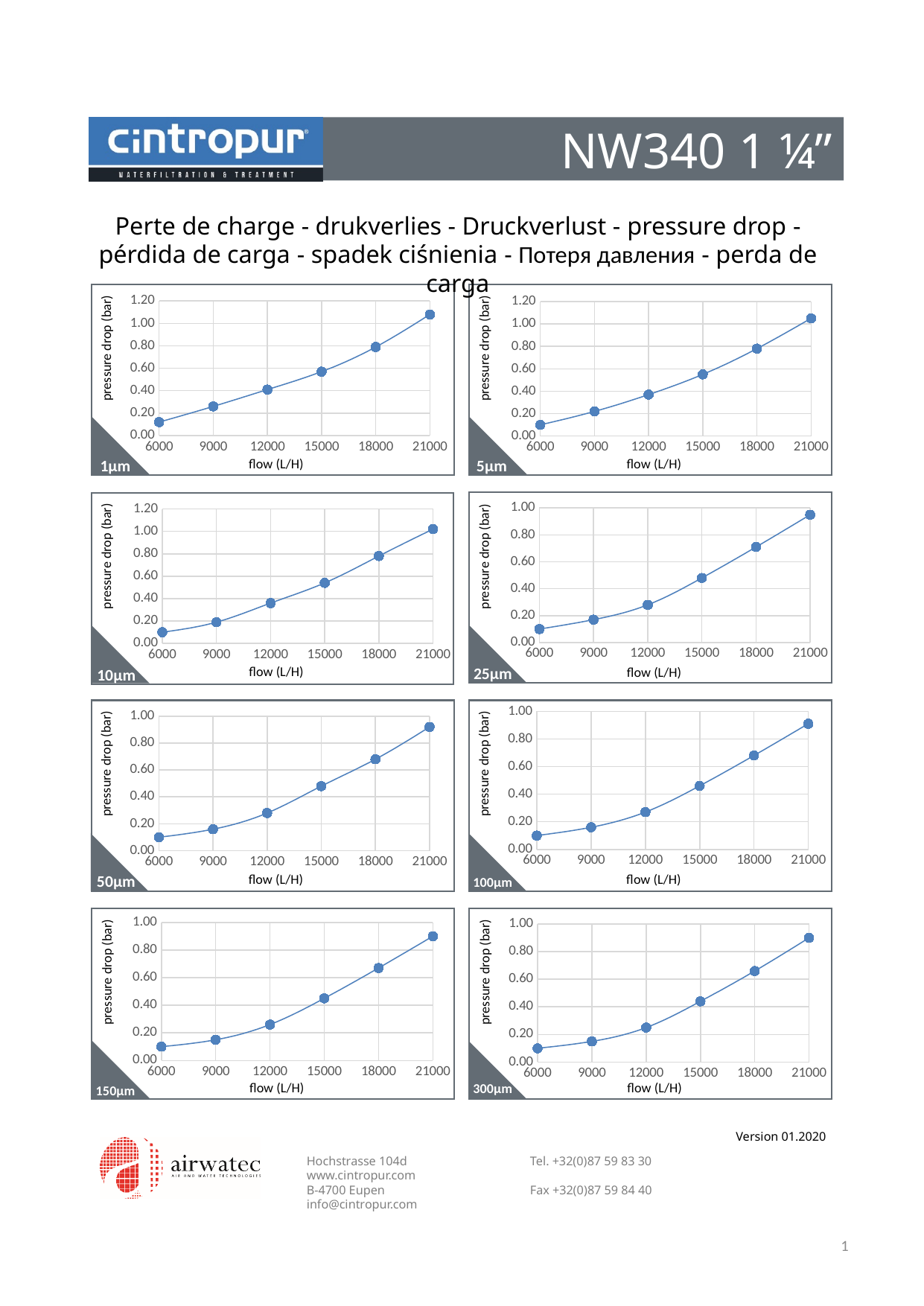
In the 5µm chart, is the pressure drop at a flow of 15000 L/H greater or less than 0.40 bar? greater How many charts are shown on the slide? 8 In the 25µm chart, does the pressure drop rise or fall as the flow increases from 6000 to 21000 L/H? rise What is the label of the vertical axis in the 5µm chart? pressure drop (bar) In the 50µm chart, is the pressure drop at a flow of 12000 L/H greater or less than 0.20 bar? greater In the 300µm chart, is the pressure drop at a flow of 6000 L/H greater or less than 0.20 bar? less How many data points are plotted in the 10µm chart? 6 What kind of chart is the 100µm chart? line chart